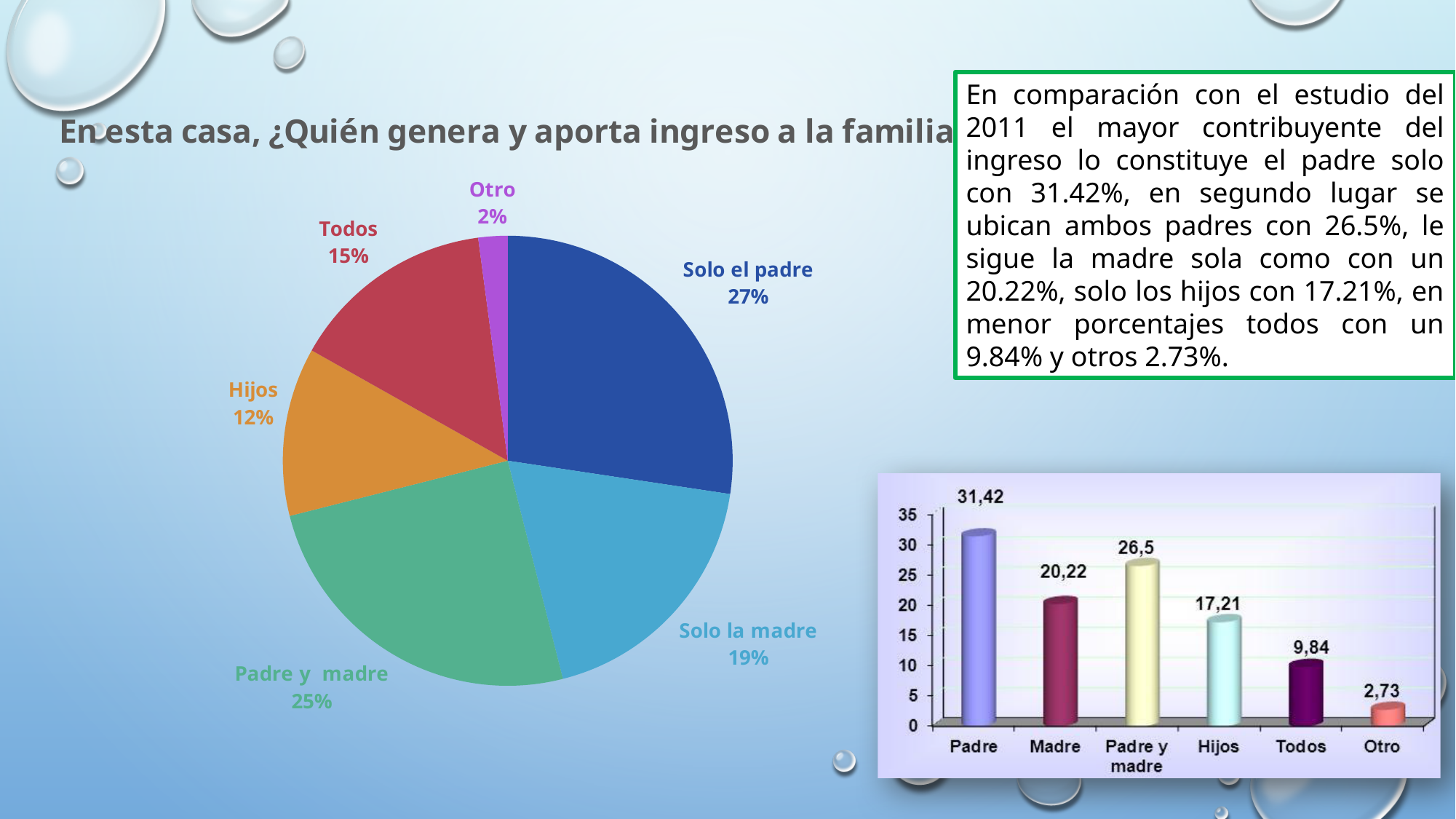
In the pie chart on the left, what is the difference between the shares of 'Padre y madre' and 'Solo la madre'? 6% What kind of chart is the chart at the bottom right of the slide? Bar chart In the pie chart on the left, which category has the smallest share? Otro In the bar chart at the bottom right, what is the value for 'Todos'? 9,84 In the bar chart at the bottom right, what is the value for 'Madre'? 20,22 What kind of chart is the chart on the left of the slide? Pie chart In the pie chart on the left, which category has the largest share? Solo el padre In the pie chart on the left, what share does 'Solo el padre' have? 27% In the bar chart at the bottom right, which category has the highest value? Padre In the pie chart on the left, how many slices are there? 6 In the pie chart on the left, what share does 'Hijos' have? 12% In the bar chart at the bottom right, which is larger, 'Padre y madre' or 'Hijos'? Padre y madre